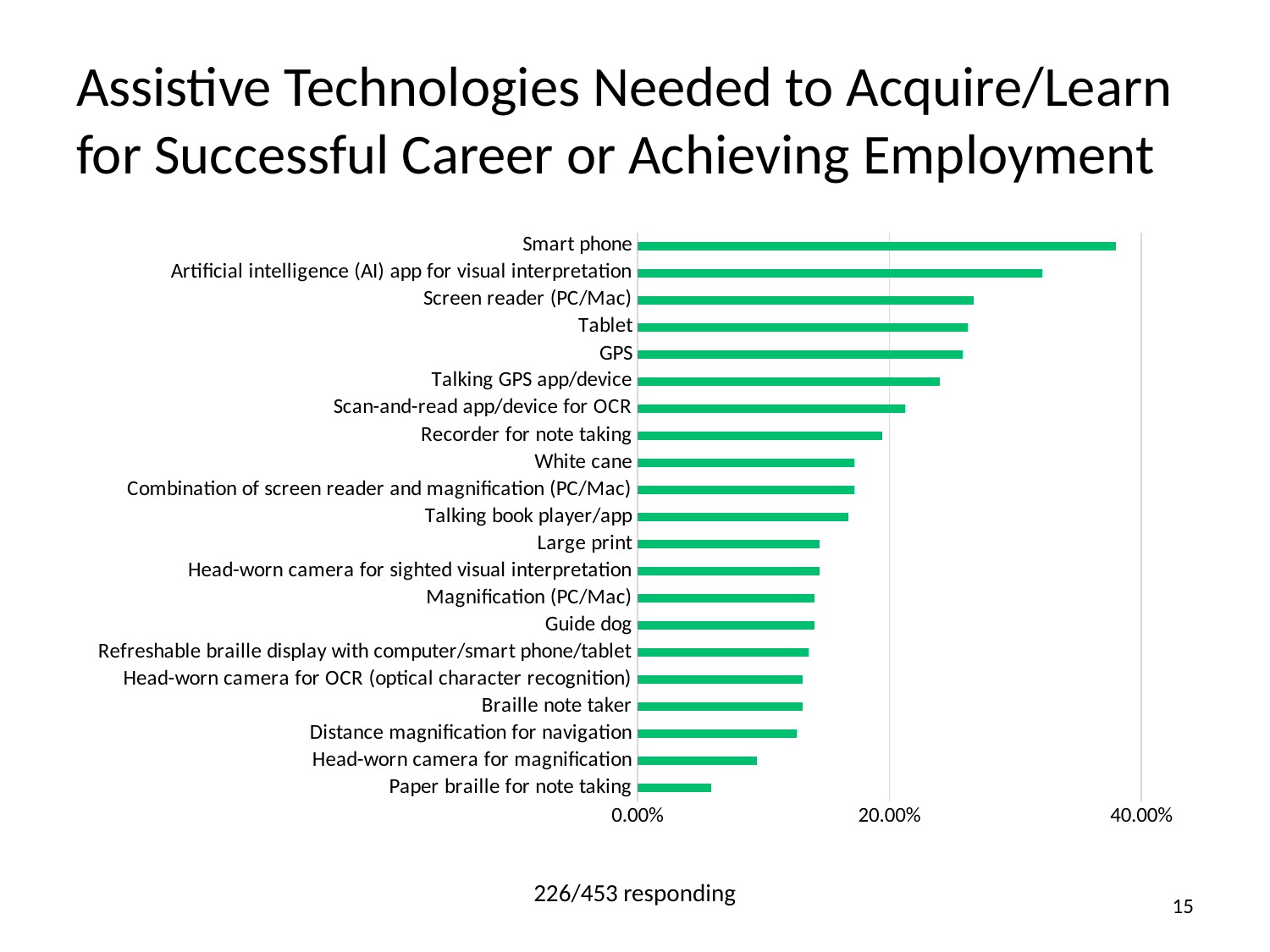
Which has the larger value, Tablet or Large print? Tablet Which assistive technology has the highest value in the chart? Smart phone Which has the larger value, Head-worn camera for magnification or White cane? White cane What kind of chart is shown on the slide? Bar chart Which assistive technology has the lowest value in the chart? Paper braille for note taking How many assistive technology categories are plotted in the chart? 21 Is the value for Smart phone greater or less than 20.00%? greater Is the value for Paper braille for note taking greater or less than 20.00%? less What is the title of the chart on the slide? Assistive Technologies Needed to Acquire/Learn for Successful Career or Achieving Employment According to the note below the chart, how many respondents answered this question? 226/453 responding Is the value for Talking GPS app/device greater or less than 20.00%? greater